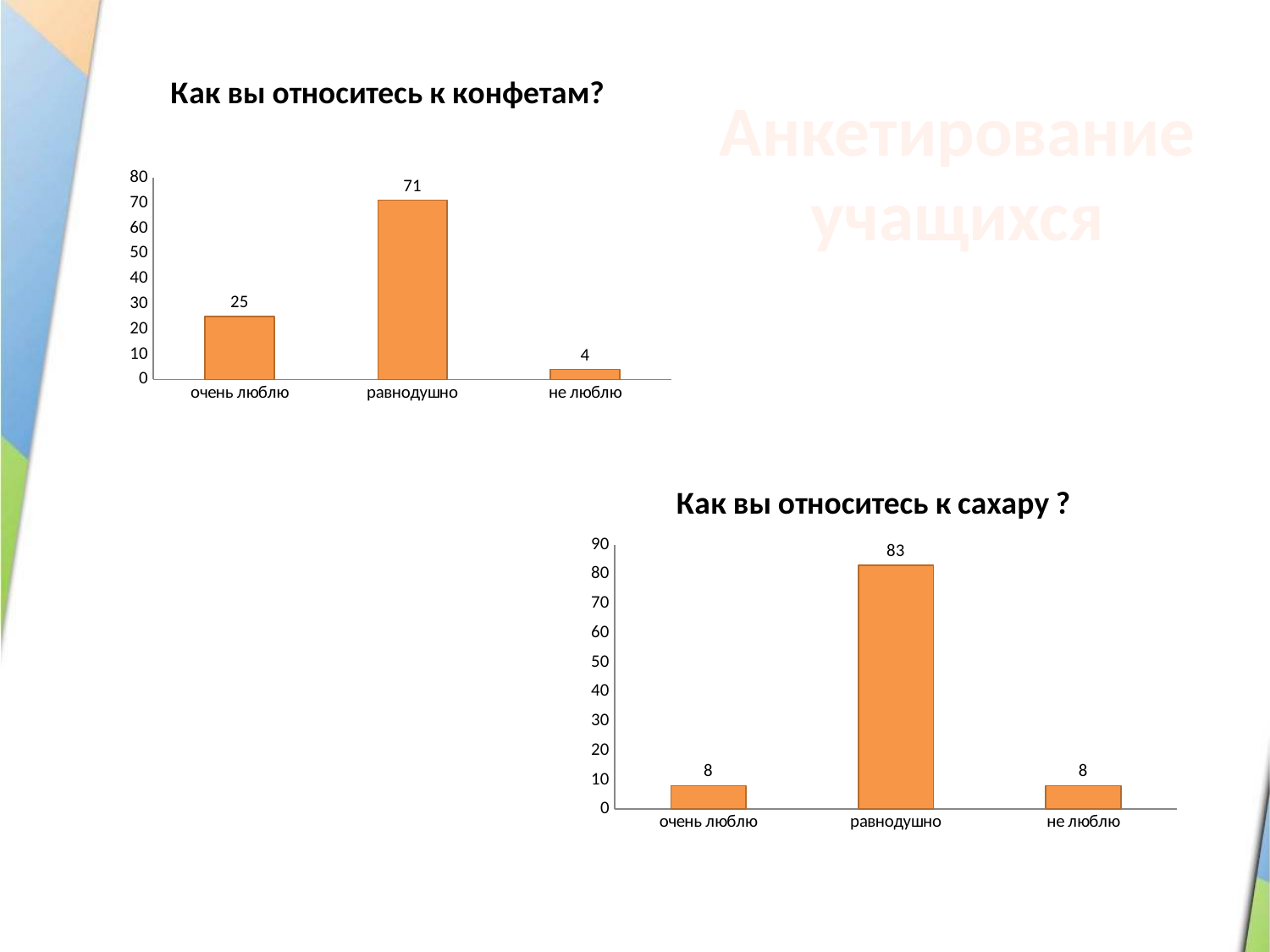
In the chart titled "Как вы относитесь к сахару ?", what is the difference between the values for "равнодушно" and "очень люблю"? 75 In the chart titled "Как вы относитесь к конфетам?", how many categories are shown on the x axis? 3 In the chart titled "Как вы относитесь к конфетам?", what is the highest value shown on the vertical axis? 80 In the chart titled "Как вы относитесь к сахару ?", what is the value for "равнодушно"? 83 In the chart titled "Как вы относитесь к конфетам?", what is the difference between the values for "равнодушно" and "очень люблю"? 46 In the chart titled "Как вы относитесь к сахару ?", which category has the highest value? равнодушно In the chart titled "Как вы относитесь к сахару ?", what type of chart is used? Bar chart In the chart titled "Как вы относитесь к сахару ?", what is the value for "не люблю"? 8 Which is larger: the value for "очень люблю" in the chart titled "Как вы относитесь к конфетам?" or the value for "очень люблю" in the chart titled "Как вы относитесь к сахару ?"? Как вы относитесь к конфетам? In the chart titled "Как вы относитесь к конфетам?", which category has the lowest value? не люблю In the chart titled "Как вы относитесь к конфетам?", what is the value for "очень люблю"? 25 In the chart titled "Как вы относитесь к конфетам?", what is the value for "равнодушно"? 71